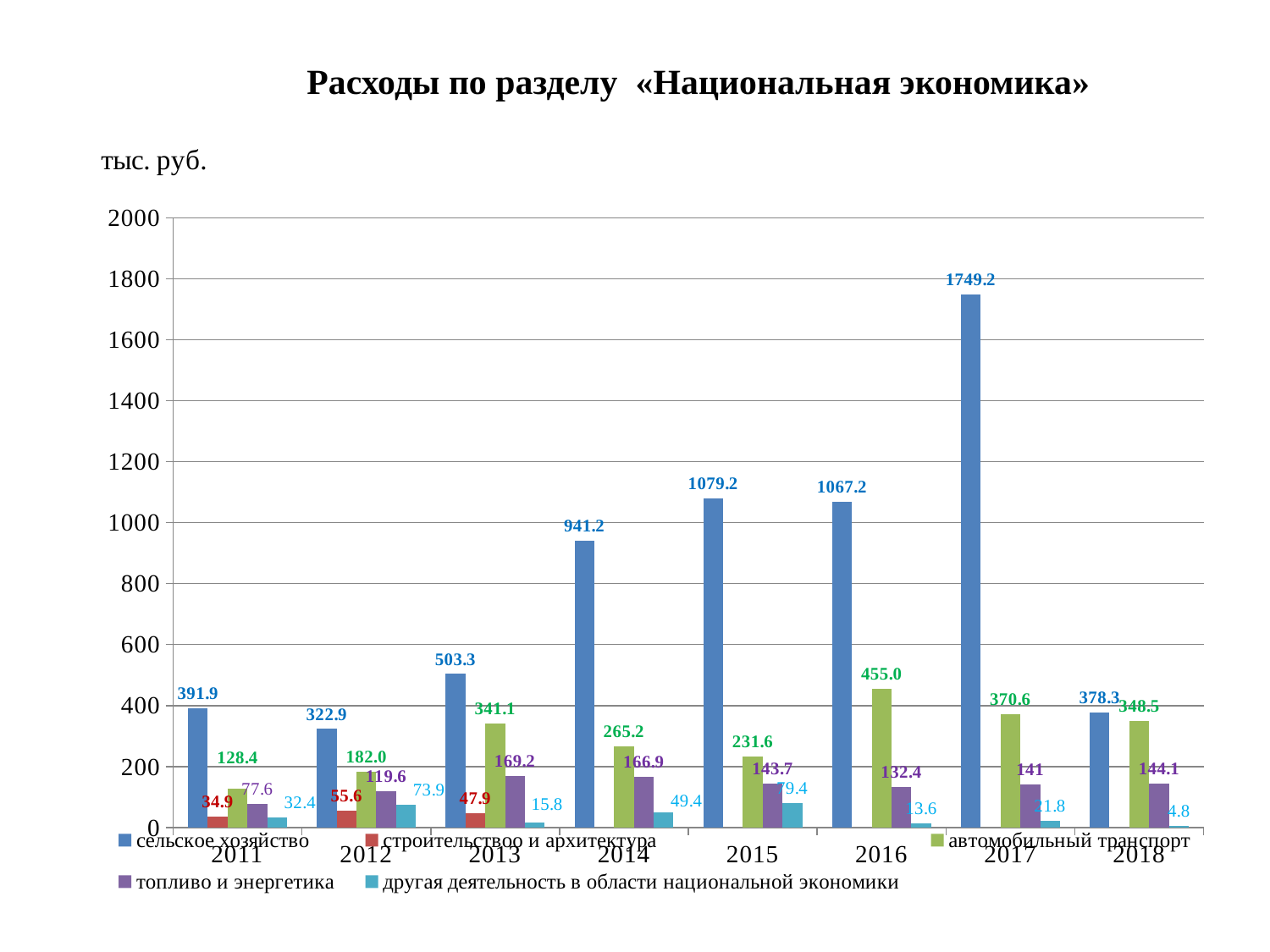
What is the value for автомобильный транспорт in 2016? 455.0 What is the value for сельское хозяйство in 2017? 1749.2 What is the title of the chart? Расходы по разделу «Национальная экономика» What is the value for топливо и энергетика in 2013? 169.2 How many series does the legend list? 5 In which year is the value for другая деятельность в области национальной экономики the lowest? 2018 What kind of chart is shown on the slide? bar chart What is the difference between the сельское хозяйство values for 2015 and 2016? 12.0 In which year is the value for сельское хозяйство the highest? 2017 Which is larger in 2018: сельское хозяйство or автомобильный транспорт? сельское хозяйство What is the value for другая деятельность в области национальной экономики in 2018? 4.8 How many years are shown on the x axis? 8